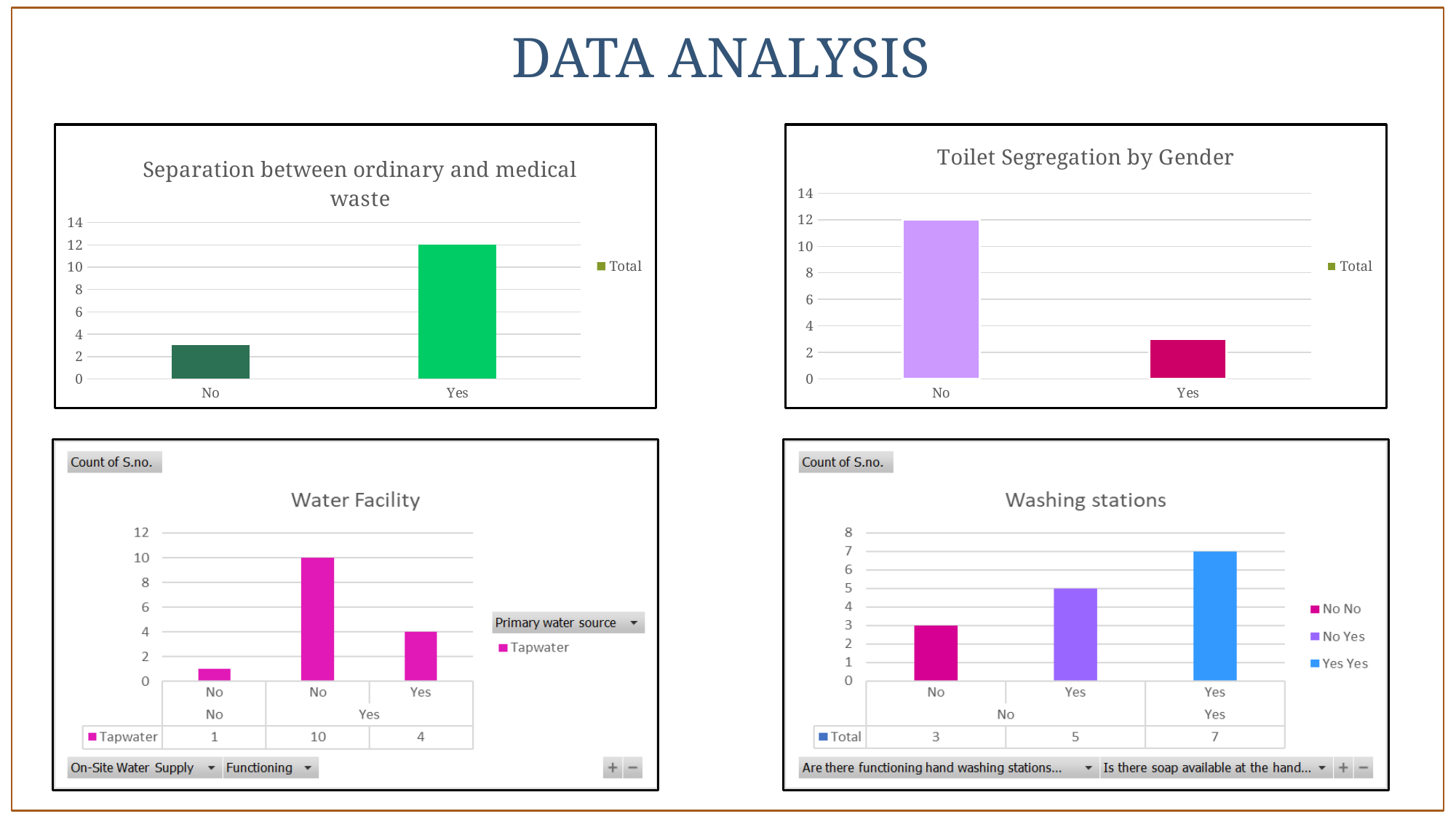
In the 'Toilet Segregation by Gender' chart, is the value for Yes greater or less than 4? less In the 'Separation between ordinary and medical waste' chart, is the value for No greater or less than 4? less In the 'Separation between ordinary and medical waste' chart, what is the value for Yes? 12 In the 'Separation between ordinary and medical waste' chart, which category has the higher value? Yes In the 'Water Facility' chart, how many bars are plotted? 3 How many entries does the legend of the 'Washing stations' chart list? 3 In the 'Toilet Segregation by Gender' chart, what is the value for No? 12 In the 'Water Facility' chart, what is the Tapwater value for the No/Yes category (the middle bar)? 10 In the 'Water Facility' chart, what is the difference between the highest and lowest Tapwater values? 9 In the 'Washing stations' chart, what is the total of the three values shown in the data table? 15 In the 'Washing stations' chart, what is the value for the Yes Yes category? 7 In the 'Toilet Segregation by Gender' chart, which category has the lower value? Yes